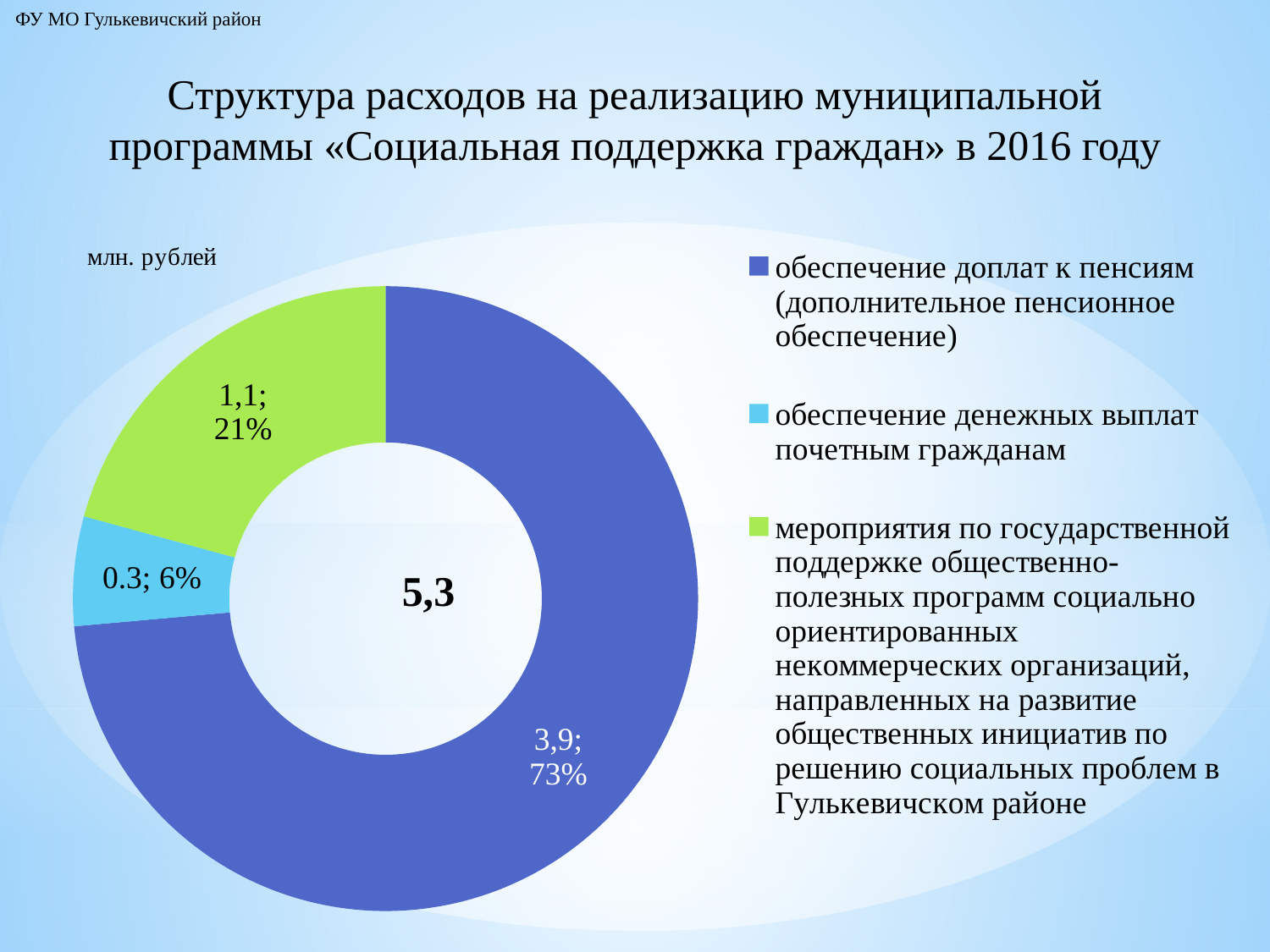
What is the difference between the value for 'обеспечение доплат к пенсиям' and the value for 'мероприятия по государственной поддержке общественно-полезных программ'? 2,8 What value is shown for the slice 'мероприятия по государственной поддержке общественно-полезных программ социально ориентированных некоммерческих организаций'? 1,1 What value is shown for the slice 'обеспечение денежных выплат почетным гражданам'? 0.3 What value is shown for the slice 'обеспечение доплат к пенсиям (дополнительное пенсионное обеспечение)'? 3,9 Which category has the smallest slice in the chart? обеспечение денежных выплат почетным гражданам What share of the chart does the slice 'обеспечение доплат к пенсиям' represent? 73% Which category has the largest slice in the chart? обеспечение доплат к пенсиям (дополнительное пенсионное обеспечение) What share of the chart does the slice 'обеспечение денежных выплат почетным гражданам' represent? 6% What total value is shown in the centre of the chart? 5,3 What kind of chart is shown on the slide? doughnut chart How many slices does the chart have? 3 What share of the chart does the slice 'мероприятия по государственной поддержке общественно-полезных программ' represent? 21%